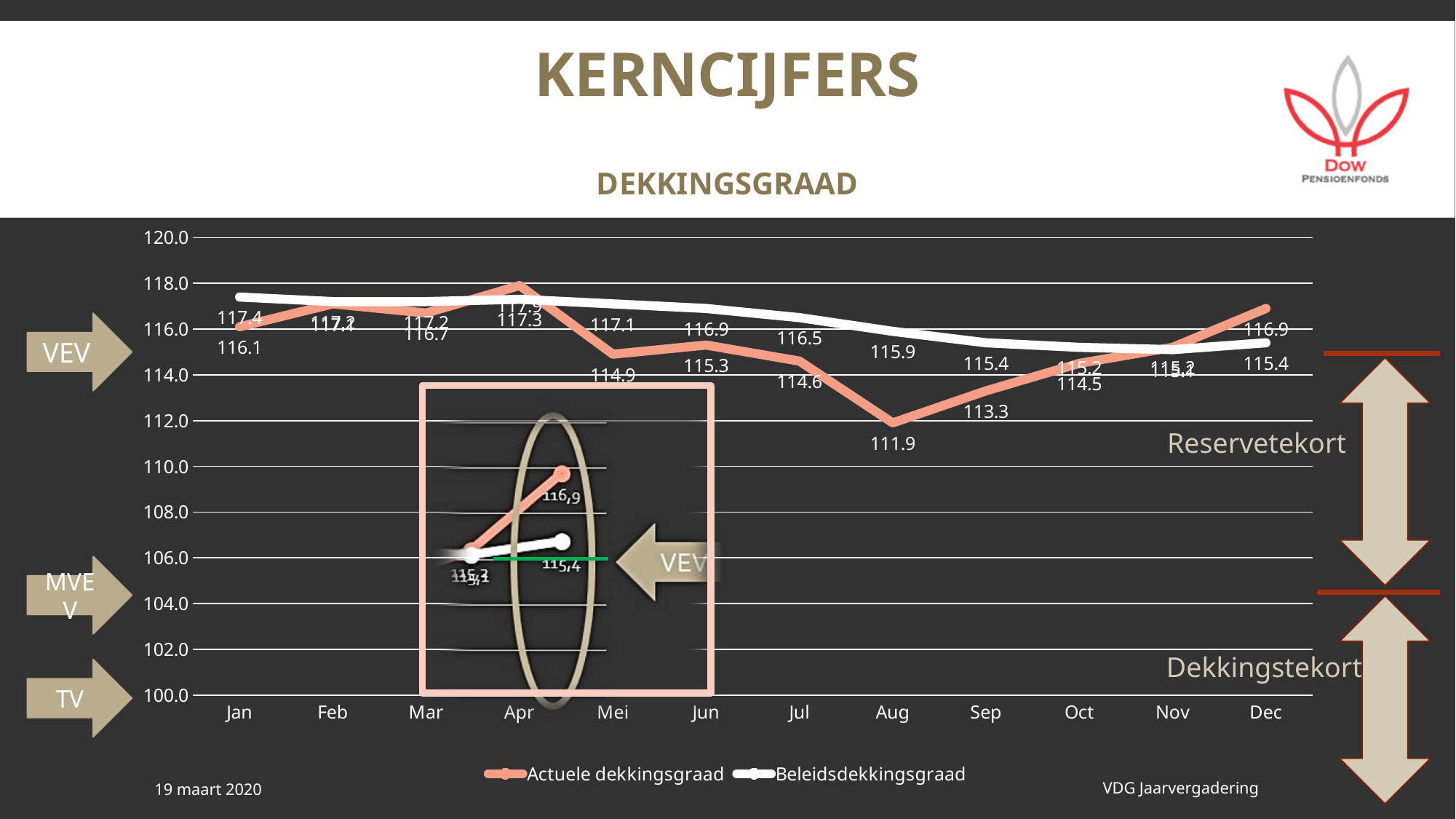
How many series does the legend list? 2 In which month is the Actuele dekkingsgraad lowest? Aug In Jun, which is larger: the Actuele dekkingsgraad or the Beleidsdekkingsgraad? Beleidsdekkingsgraad What is the difference between the Beleidsdekkingsgraad and the Actuele dekkingsgraad in Aug? 4.0 What is the difference between the Actuele dekkingsgraad and the Beleidsdekkingsgraad in Dec? 1.5 What is the Actuele dekkingsgraad in Dec? 116.9 How many months are plotted along the x axis? 12 What kind of chart is shown on the slide? line chart Is the Actuele dekkingsgraad in Sep greater or less than 114.0? less What is the Actuele dekkingsgraad in Aug? 111.9 Does the Actuele dekkingsgraad rise or fall from Aug to Dec? rise What is the Beleidsdekkingsgraad in Jan? 117.4